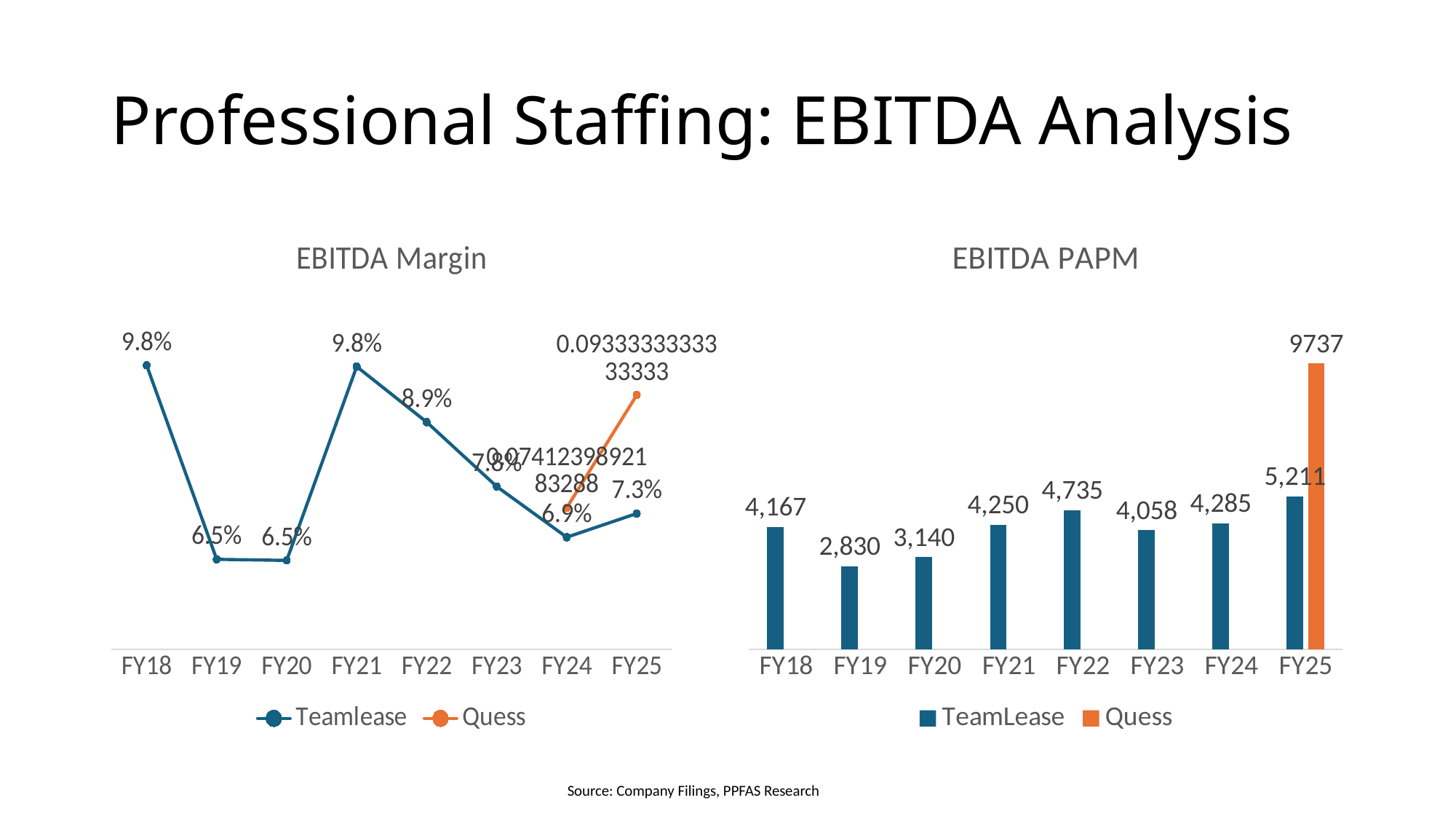
In the EBITDA Margin chart, what is the difference between the Teamlease values for FY21 and FY24? 2.9 percentage points In the EBITDA PAPM chart, what is the TeamLease value for FY22? 4,735 In the EBITDA Margin chart, which year has the lowest Teamlease value? FY19 and FY20 (6.5%) In the EBITDA Margin chart, how many series does the legend list? 2 In the EBITDA PAPM chart, what is the Quess value for FY25? 9737 In the EBITDA Margin chart, what is the Teamlease value for FY25? 7.3% In the EBITDA Margin chart, what is the Teamlease value for FY22? 8.9% In the EBITDA PAPM chart, what is the difference between the TeamLease values for FY25 and FY18? 1,044 How many years are shown on the x axis of the EBITDA PAPM chart? 8 What kind of chart is the EBITDA Margin chart? Line chart In the EBITDA PAPM chart, which year has the lowest TeamLease value? FY19 In the EBITDA PAPM chart, which is larger for FY25, TeamLease or Quess? Quess